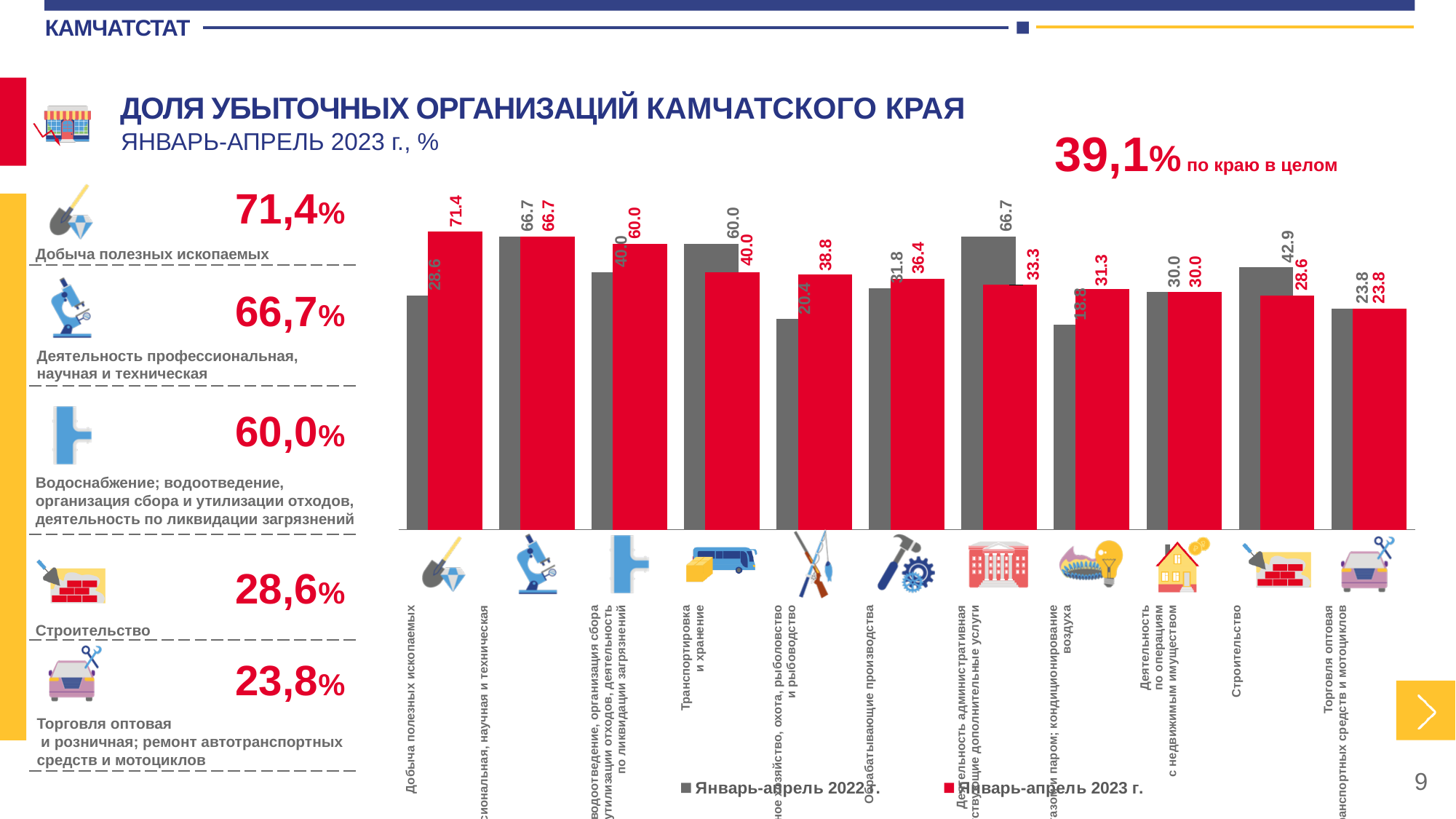
How many categories (industries) are shown on the x axis of the chart? 11 What is the value for Обрабатывающие производства in Январь-апрель 2023 г.? 36.4 What is the difference between the 2023 and 2022 values for Добыча полезных ископаемых? 42.8 What colour represents the Январь-апрель 2023 г. series in the chart? red Which category has the highest value in the Январь-апрель 2023 г. series? Добыча полезных ископаемых What type of chart is shown on the slide? bar chart How many series does the legend list? 2 What is the value for Добыча полезных ископаемых in Январь-апрель 2023 г.? 71.4 What is the value for Строительство in Январь-апрель 2022 г.? 42.9 Which is larger for Строительство: the Январь-апрель 2022 г. value or the Январь-апрель 2023 г. value? Январь-апрель 2022 г. What is the value for Добыча полезных ископаемых in Январь-апрель 2022 г.? 28.6 What is the value for Транспортировка и хранение in Январь-апрель 2023 г.? 40.0